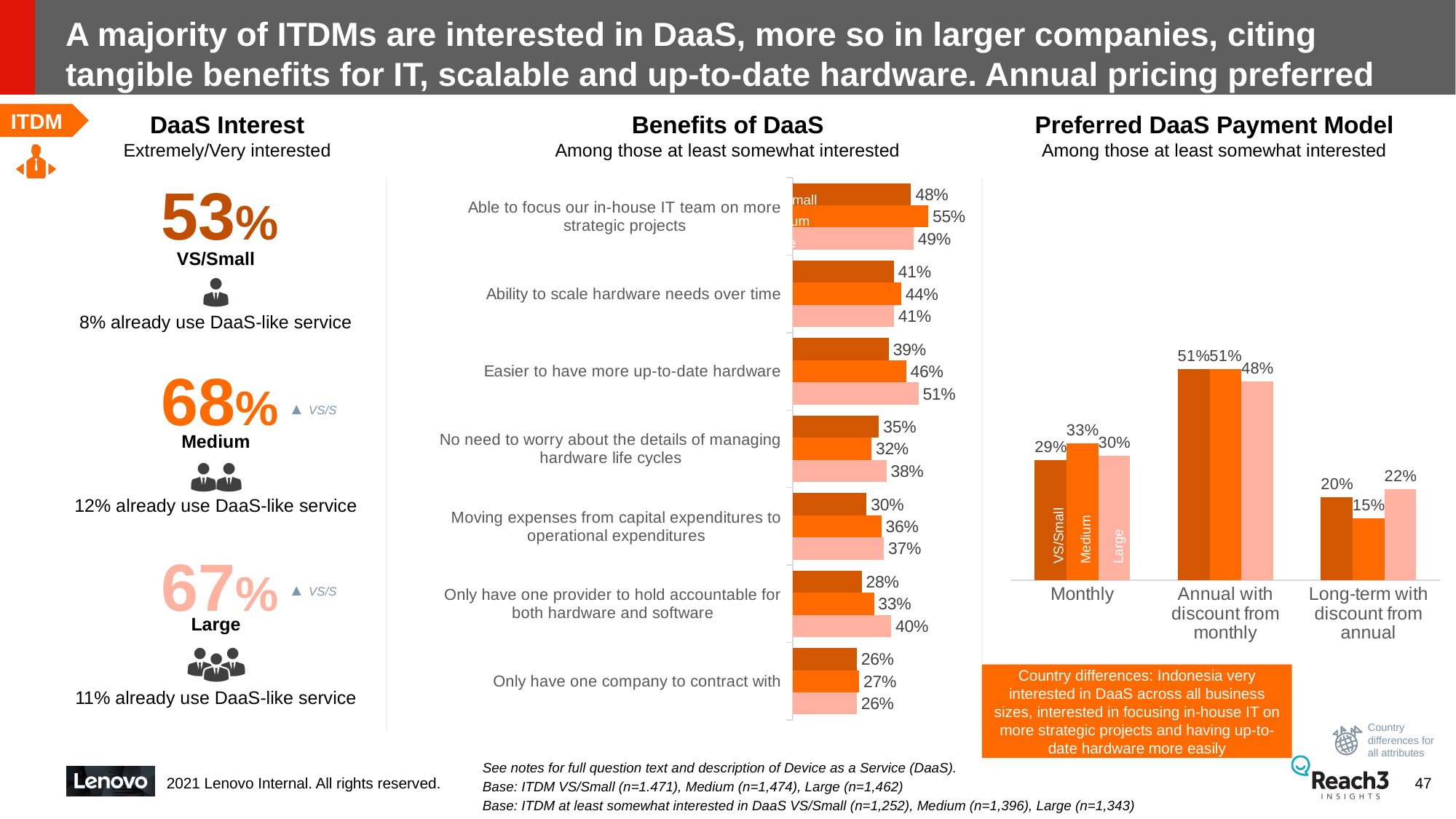
In the Preferred DaaS Payment Model chart, what percentage of VS/Small respondents prefer the Monthly payment model? 29% In the Benefits of DaaS chart, what is the value of the middle orange (Medium) bar for 'Able to focus our in-house IT team on more strategic projects'? 55% In the Preferred DaaS Payment Model chart, which payment model has the highest value for Medium companies? Annual with discount from monthly In the Preferred DaaS Payment Model chart, how many payment model categories are shown on the x axis? 3 In the Preferred DaaS Payment Model chart, what is the value for Large companies for 'Long-term with discount from annual'? 22% In the Benefits of DaaS chart, for 'Only have one provider to hold accountable for both hardware and software', is the light pink (Large) bar at 40% larger or smaller than the dark orange (VS/Small) bar at 28%? Larger In the Benefits of DaaS chart, what is the value of the light pink (Large) bar for 'Easier to have more up-to-date hardware'? 51% In the Benefits of DaaS chart, which benefit has the lowest value for the top dark orange (VS/Small) bar? Only have one company to contract with What type of chart is the Benefits of DaaS chart? Bar chart In the Preferred DaaS Payment Model chart, how many company-size series are plotted? 3 In the Preferred DaaS Payment Model chart, what is the difference between the Medium values for 'Annual with discount from monthly' and 'Monthly'? 18% In the Benefits of DaaS chart, how many benefit categories are listed? 7